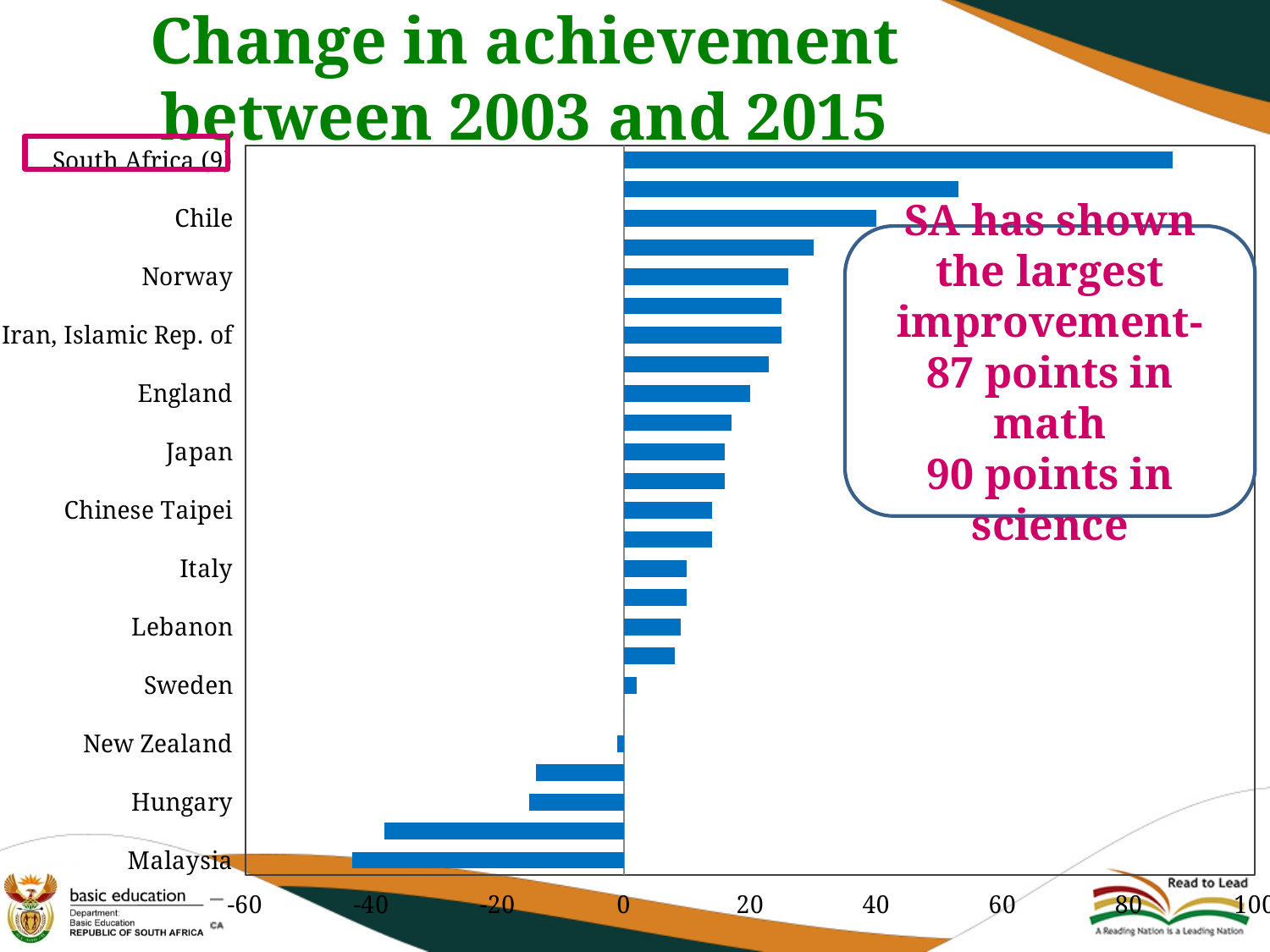
Which country shows the largest change in achievement? South Africa Is the value for South Africa greater or less than 80? greater Is the value for Norway greater or less than 40? less Is the value for Malaysia greater or less than -40? less What is the title of the slide's chart? Change in achievement between 2003 and 2015 Going from the top of the chart to the bottom, do the bar values increase or decrease? decrease Which labelled country shows the lowest (most negative) change in achievement? Malaysia Which has the larger change in achievement, Chile or Norway? Chile Which has the larger change in achievement, England or Italy? England What kind of chart is shown on the slide? Bar chart